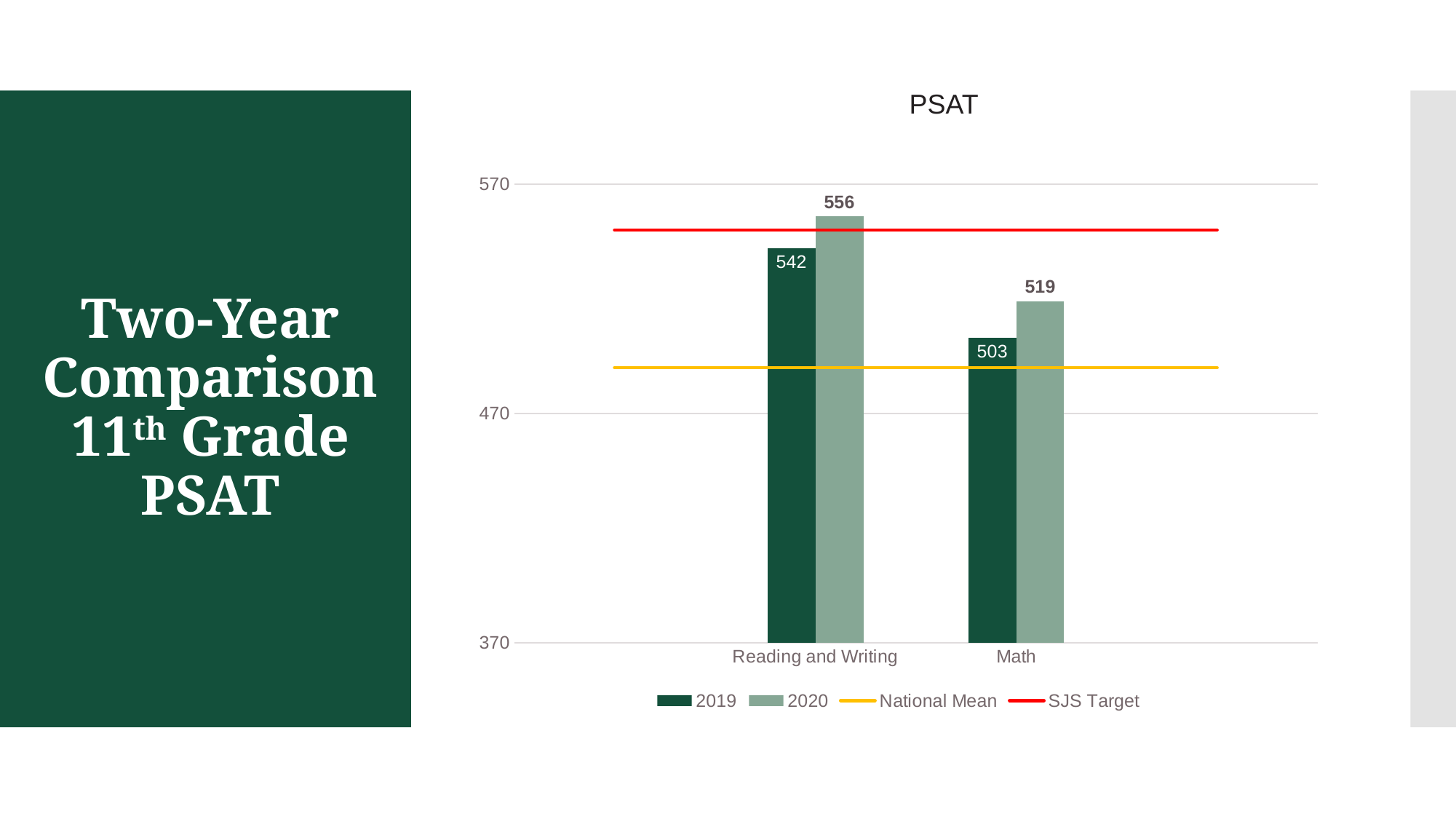
Which is larger, the 2019 value for Reading and Writing or the 2020 value for Math? 2019 value for Reading and Writing What is the 2020 value for Math? 519 What kind of chart is shown? Bar chart Which category has the highest 2020 value? Reading and Writing What is the 2019 value for Math? 503 How many series does the legend list? 4 What is the difference between the 2020 and 2019 values for Reading and Writing? 14 What is the 2020 value for Reading and Writing? 556 Which category has the lowest 2019 value? Math What is the difference between the 2020 and 2019 values for Math? 16 How many categories are shown on the x axis? 2 What is the 2019 value for Reading and Writing? 542